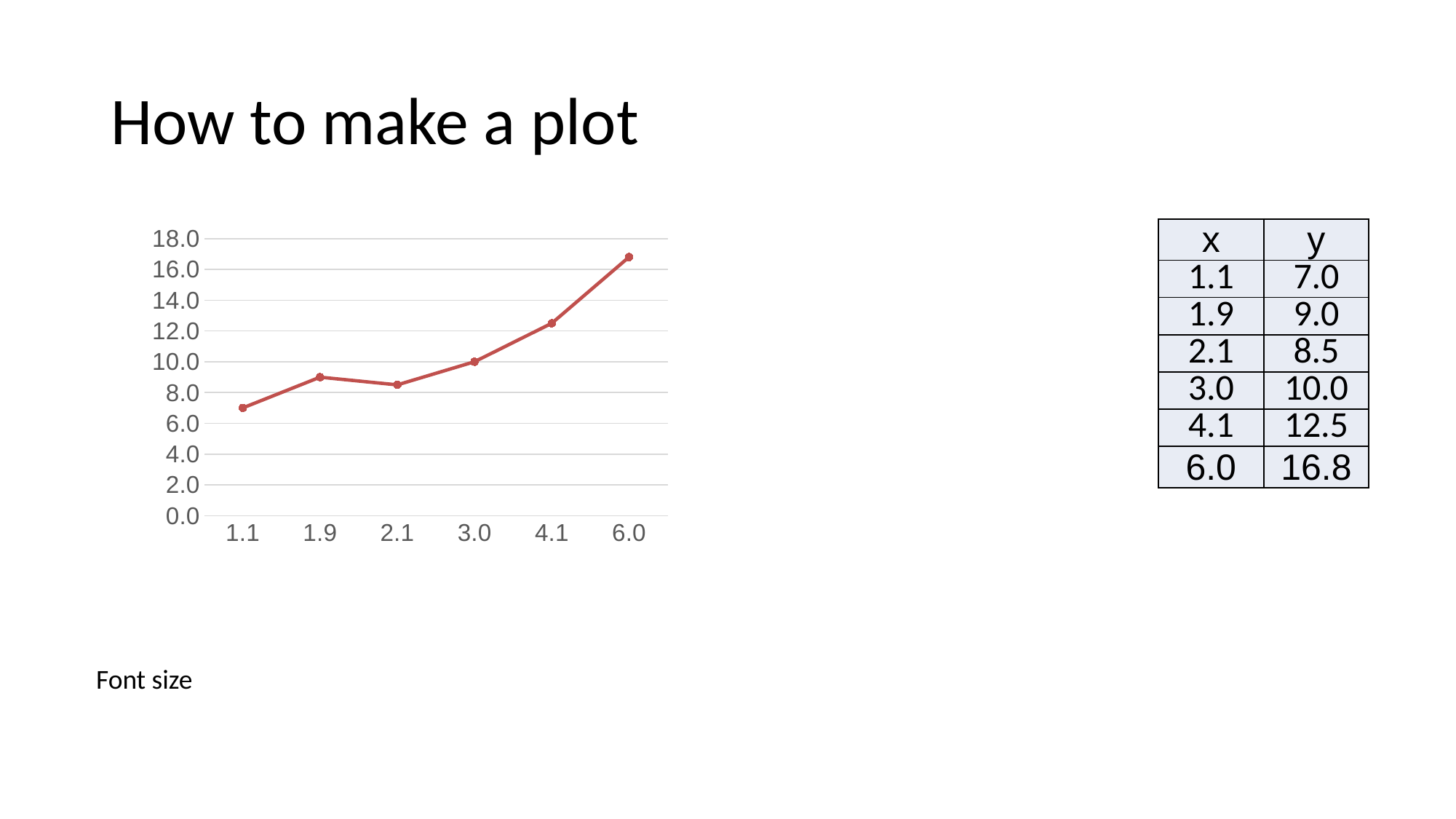
What kind of chart is shown on the slide? line chart What is the y value at x = 3.0? 10.0 What is the difference between the y values at x = 6.0 and x = 4.1? 4.3 Is the y value at x = 4.1 greater or less than 12.0? greater At which x value is y lowest? 1.1 Which has the larger y value, x = 1.9 or x = 2.1? 1.9 Does the line generally rise or fall from x = 2.1 to x = 6.0? rise What is the highest value shown on the vertical axis of the chart? 18.0 What is the y value at x = 6.0? 16.8 What is the y value at x = 1.1? 7.0 At which x value is y highest? 6.0 How many data points are plotted on the line chart? 6